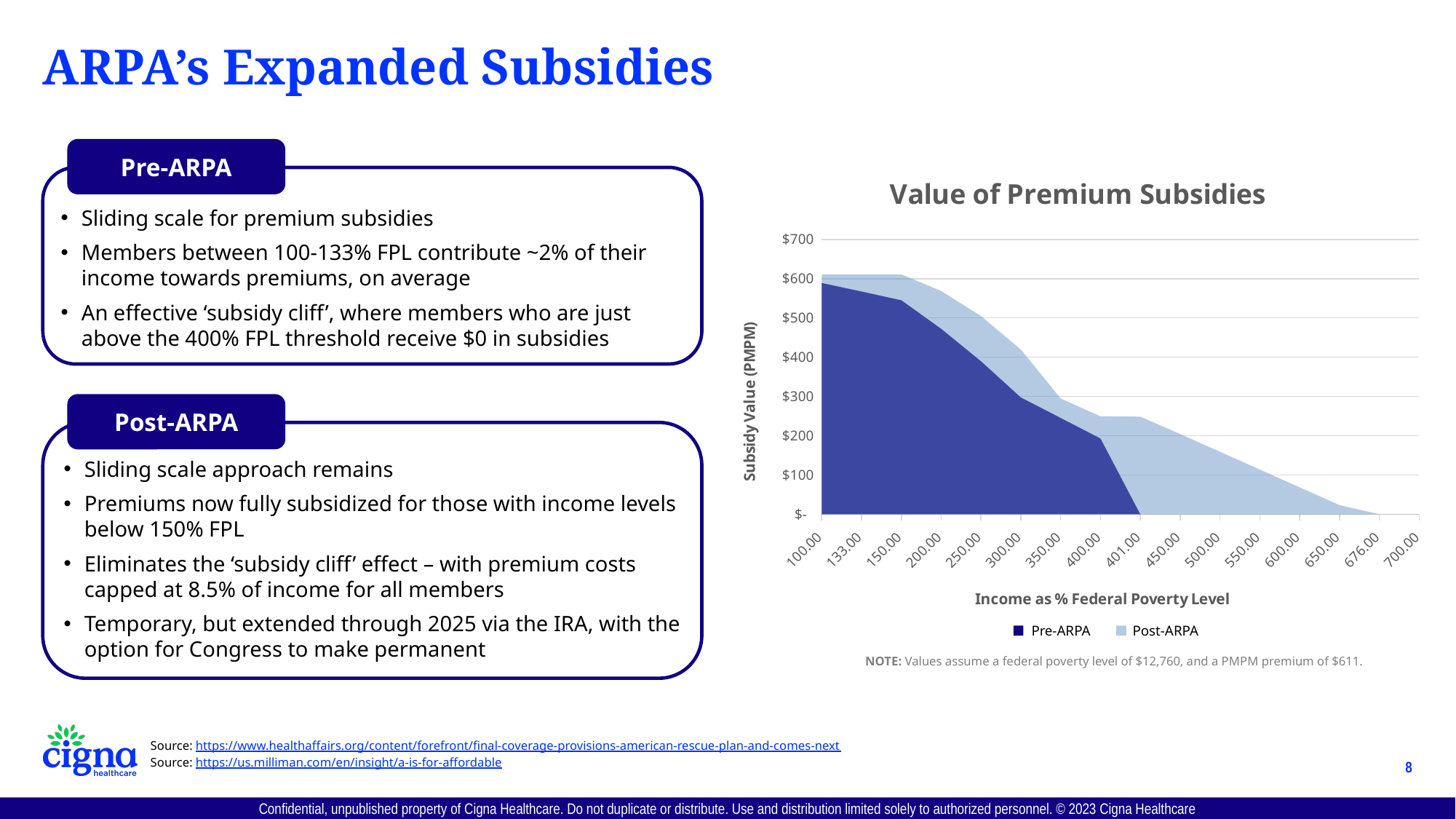
Is the Pre-ARPA subsidy value at 350.00% FPL greater or less than $300? less What is the label of the y axis of the chart? Subsidy Value (PMPM) What is the title of the chart? Value of Premium Subsidies How many income categories are shown on the x axis of the chart? 16 Is the Post-ARPA subsidy value at 250.00% FPL greater or less than $400? greater Is the Pre-ARPA subsidy value at 401.00% FPL greater or less than $100? less How many series does the chart legend list? 2 Do the subsidy values rise or fall as income as % of Federal Poverty Level increases? Fall At 300.00% FPL, which series has the higher subsidy value, Pre-ARPA or Post-ARPA? Post-ARPA What type of chart is shown on the slide? Area chart